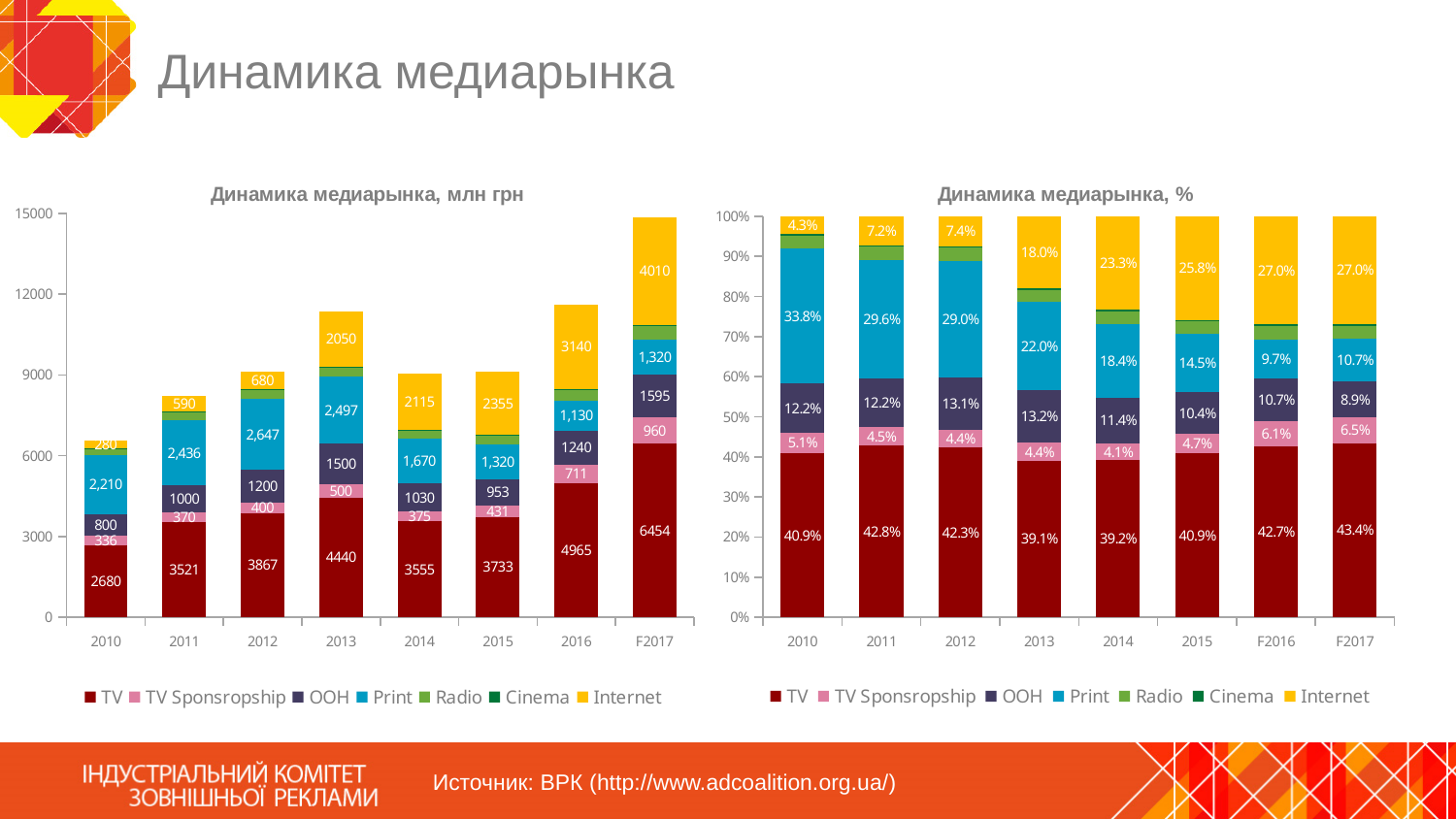
How many years are shown on the x axis of the chart "Динамика медиарынка, %"? 8 In the chart "Динамика медиарынка, %", does the Print share rise or fall from 2010 to F2016? fall In the chart "Динамика медиарынка, млн грн", which is larger in 2015: the Print value or the Internet value? Internet In the chart "Динамика медиарынка, млн грн", what is the difference between the TV values for F2017 and 2016? 1489 In the chart "Динамика медиарынка, млн грн", which year has the highest TV value? F2017 In the chart "Динамика медиарынка, %", what is the TV share for 2010? 40.9% In the chart "Динамика медиарынка, %", which year has the highest Print share? 2010 In the chart "Динамика медиарынка, %", what is the Print share for 2014? 18.4% In the chart "Динамика медиарынка, млн грн", which year has the lowest Internet value? 2010 In the chart "Динамика медиарынка, млн грн", what is the TV value for 2013? 4440 How many series does the legend of the chart "Динамика медиарынка, млн грн" list? 7 In the chart "Динамика медиарынка, млн грн", what is the Internet value for F2017? 4010